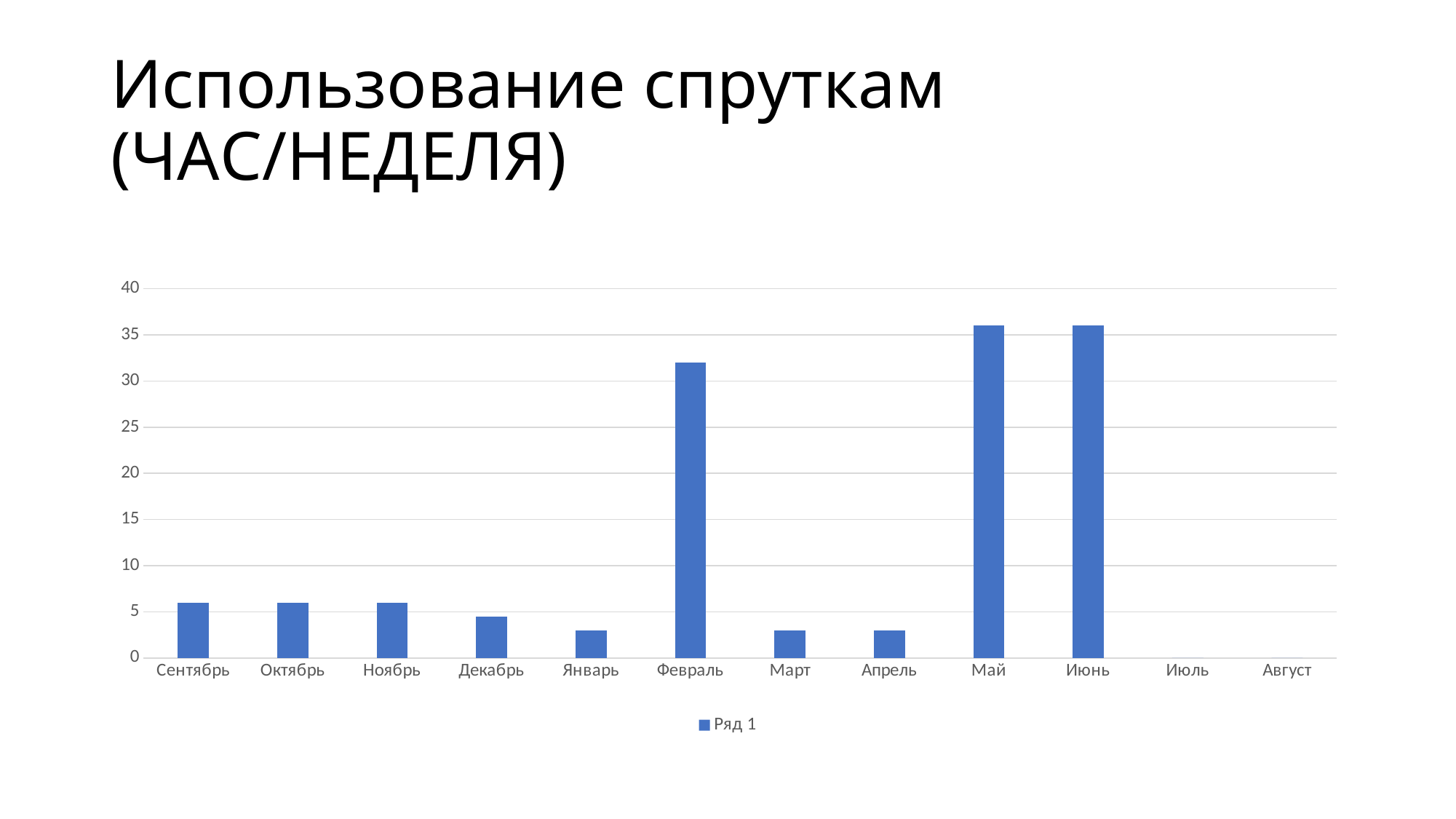
Is the value for Май greater or less than 30? greater Is the value for Сентябрь greater or less than 5? greater Which is larger, the value for Октябрь or the value for Март? Октябрь Is the value for Февраль greater or less than 30? greater How many series does the legend list? 1 What is the name of the series in the legend? Ряд 1 How many categories (months) are shown on the x axis? 12 What kind of chart is shown on the slide? bar chart Which is larger, the value for Февраль or the value for Май? Май What is the title of the chart slide? Использование спруткам (ЧАС/НЕДЕЛЯ)